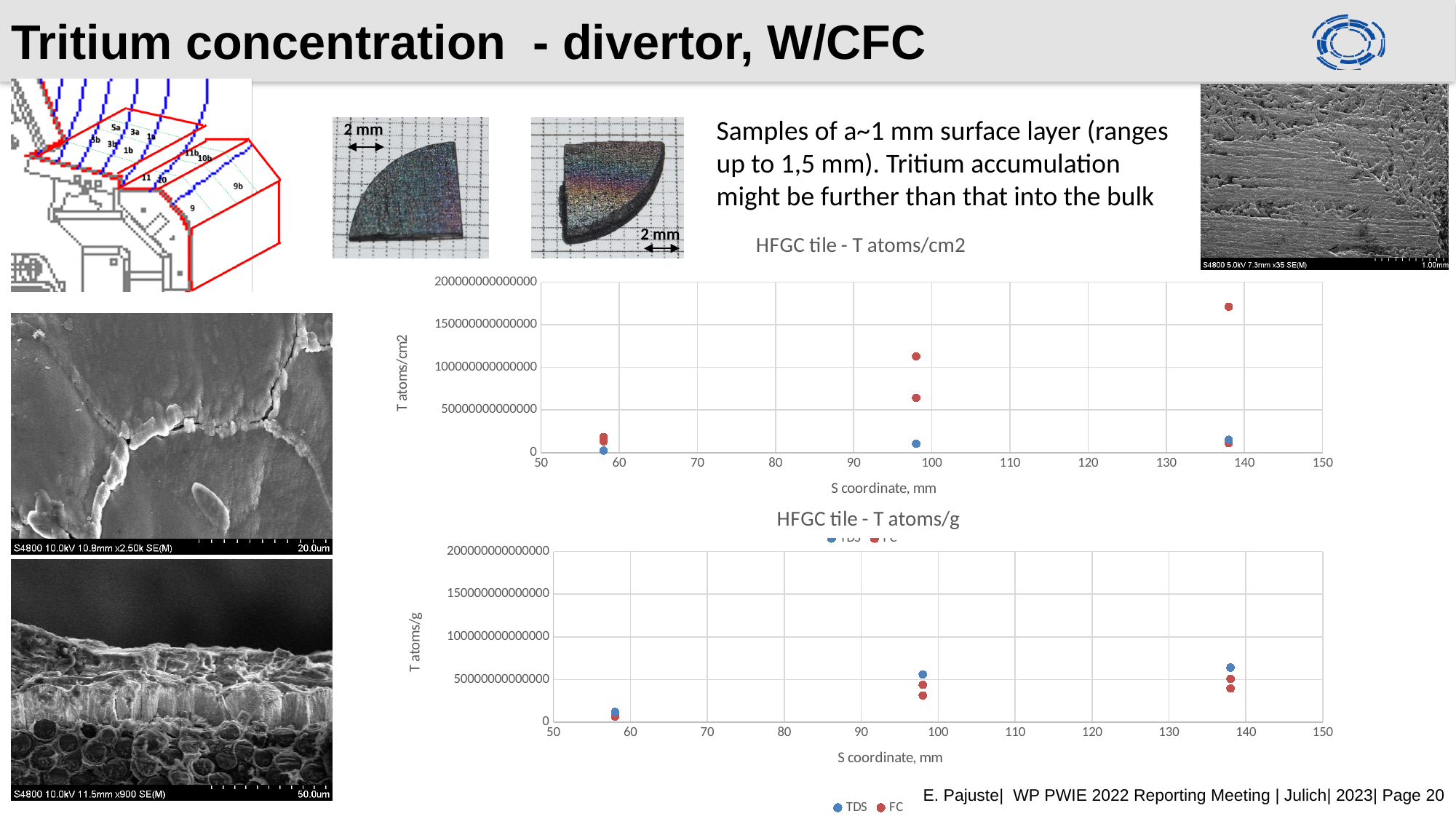
What are the two series named in the legend of the 'HFGC tile - T atoms/g' chart? TDS and FC In the 'HFGC tile - T atoms/g' chart, at how many distinct S coordinate positions are points plotted? 3 In the 'HFGC tile - T atoms/cm2' chart, is the highest FC value greater or less than 150000000000000? greater In the 'HFGC tile - T atoms/cm2' chart, which series has the highest plotted point? FC In the 'HFGC tile - T atoms/g' chart, is the highest plotted value greater or less than 100000000000000? less How many series does the legend of the 'HFGC tile - T atoms/g' chart list? 2 In the 'HFGC tile - T atoms/g' chart, is the highest TDS value greater or less than 50000000000000? greater In the 'HFGC tile - T atoms/g' chart, which series has the highest plotted point? TDS In the 'HFGC tile - T atoms/g' chart, do the TDS values rise or fall as the S coordinate increases? rise What is the x-axis label of the 'HFGC tile - T atoms/cm2' chart? S coordinate, mm What kind of chart is the 'HFGC tile - T atoms/cm2' chart? scatter chart